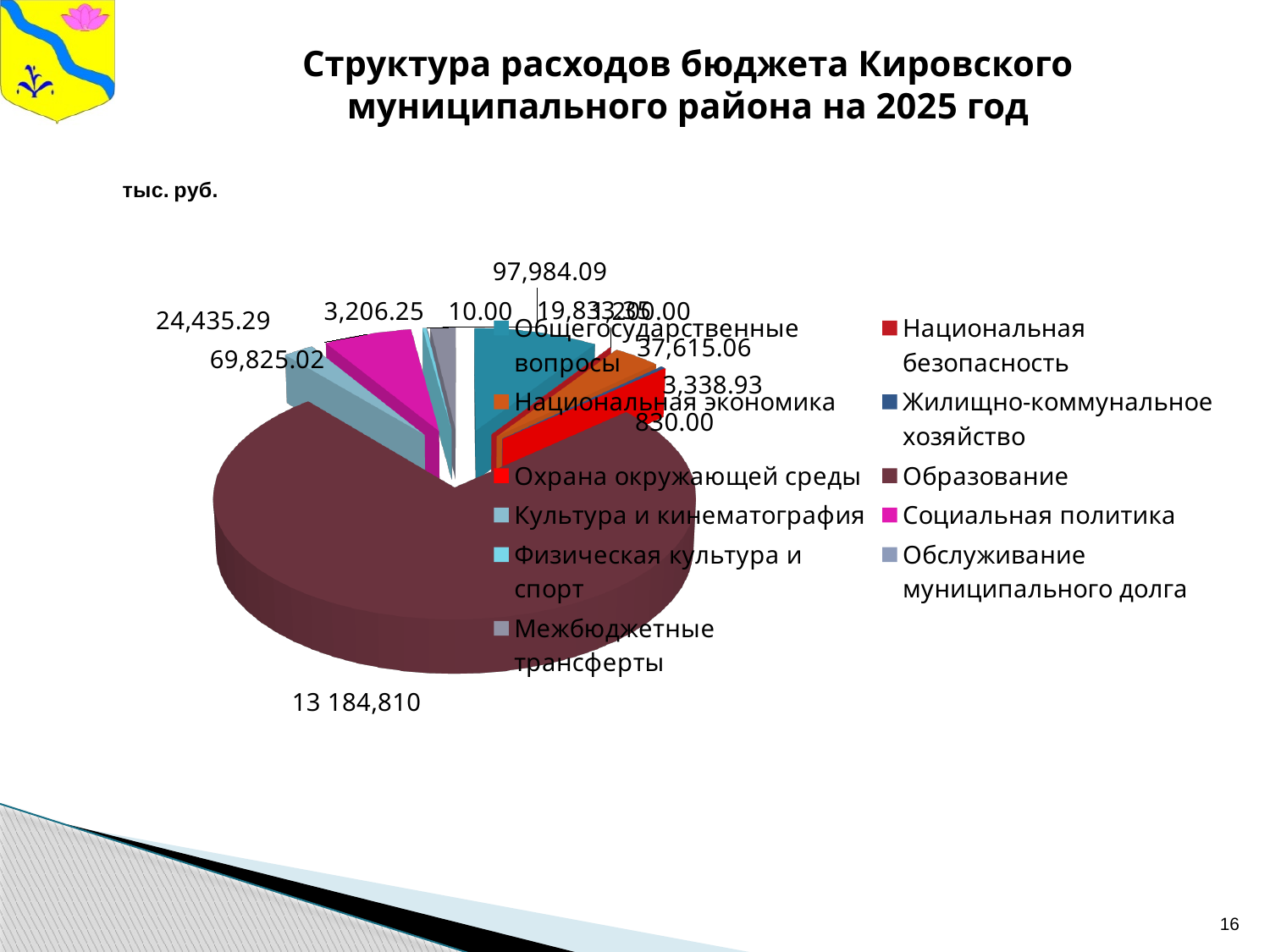
What is the value shown for Культура и кинематография? 24,435.29 In what units are the values of the chart given, according to the slide? тыс. руб. Which category has the largest slice of the pie chart? Образование What is the difference between the values for Общегосударственные вопросы and Национальная экономика? 60,369.03 What kind of chart is shown on the slide? pie chart Which is larger, Общегосударственные вопросы or Национальная экономика? Общегосударственные вопросы What is the value shown for Социальная политика? 69,825.02 What is the difference between the values for Культура и кинематография and Социальная политика? 45,389.73 What is the value shown for Общегосударственные вопросы? 97,984.09 What is the value shown for Национальная экономика? 37,615.06 What is the value shown for Образование? 13 184,810 How many categories does the legend of the pie chart list? 11